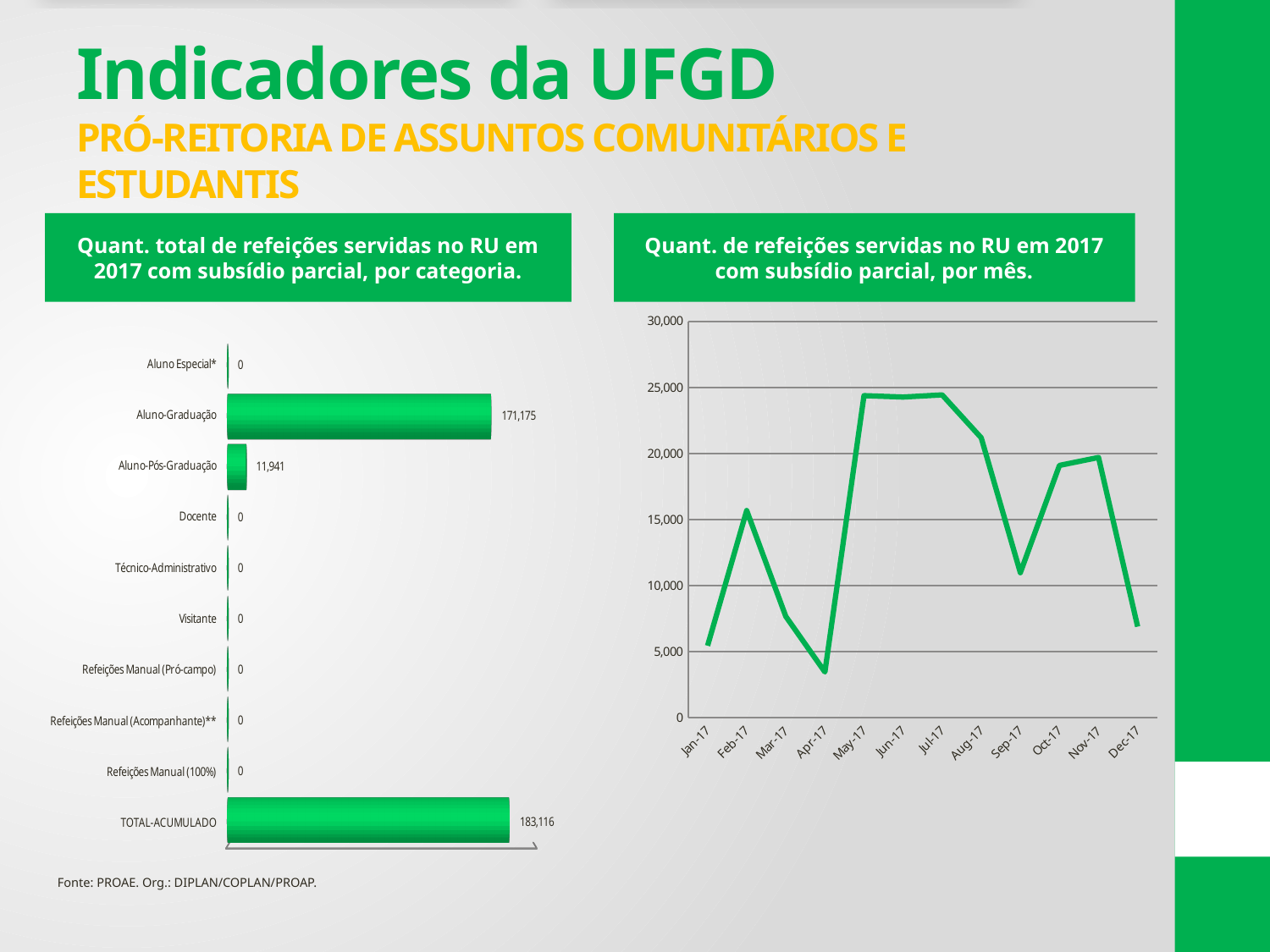
In the chart 'Quant. de refeições servidas no RU em 2017 com subsídio parcial, por mês', which is larger, the value for Feb-17 or Mar-17? Feb-17 In the chart 'Quant. total de refeições servidas no RU em 2017 com subsídio parcial, por categoria', what is the value for Aluno-Pós-Graduação? 11,941 In the chart 'Quant. total de refeições servidas no RU em 2017 com subsídio parcial, por categoria', what is the value for TOTAL-ACUMULADO? 183,116 In the chart 'Quant. de refeições servidas no RU em 2017 com subsídio parcial, por mês', is the value for Apr-17 greater or less than 5,000? less In the chart 'Quant. total de refeições servidas no RU em 2017 com subsídio parcial, por categoria', how many categories are shown? 10 In the chart 'Quant. de refeições servidas no RU em 2017 com subsídio parcial, por mês', which month has the lowest value? Apr-17 In the chart 'Quant. total de refeições servidas no RU em 2017 com subsídio parcial, por categoria', what is the difference between Aluno-Graduação and Aluno-Pós-Graduação? 159,234 In the chart 'Quant. de refeições servidas no RU em 2017 com subsídio parcial, por mês', is the value for May-17 greater or less than 20,000? greater In the chart 'Quant. de refeições servidas no RU em 2017 com subsídio parcial, por mês', how many months are plotted? 12 What kind of chart is the left chart, 'Quant. total de refeições servidas no RU em 2017 com subsídio parcial, por categoria'? Bar chart In the chart 'Quant. de refeições servidas no RU em 2017 com subsídio parcial, por mês', is the value for Dec-17 greater or less than 10,000? less In the chart 'Quant. total de refeições servidas no RU em 2017 com subsídio parcial, por categoria', what is the value for Aluno-Graduação? 171,175